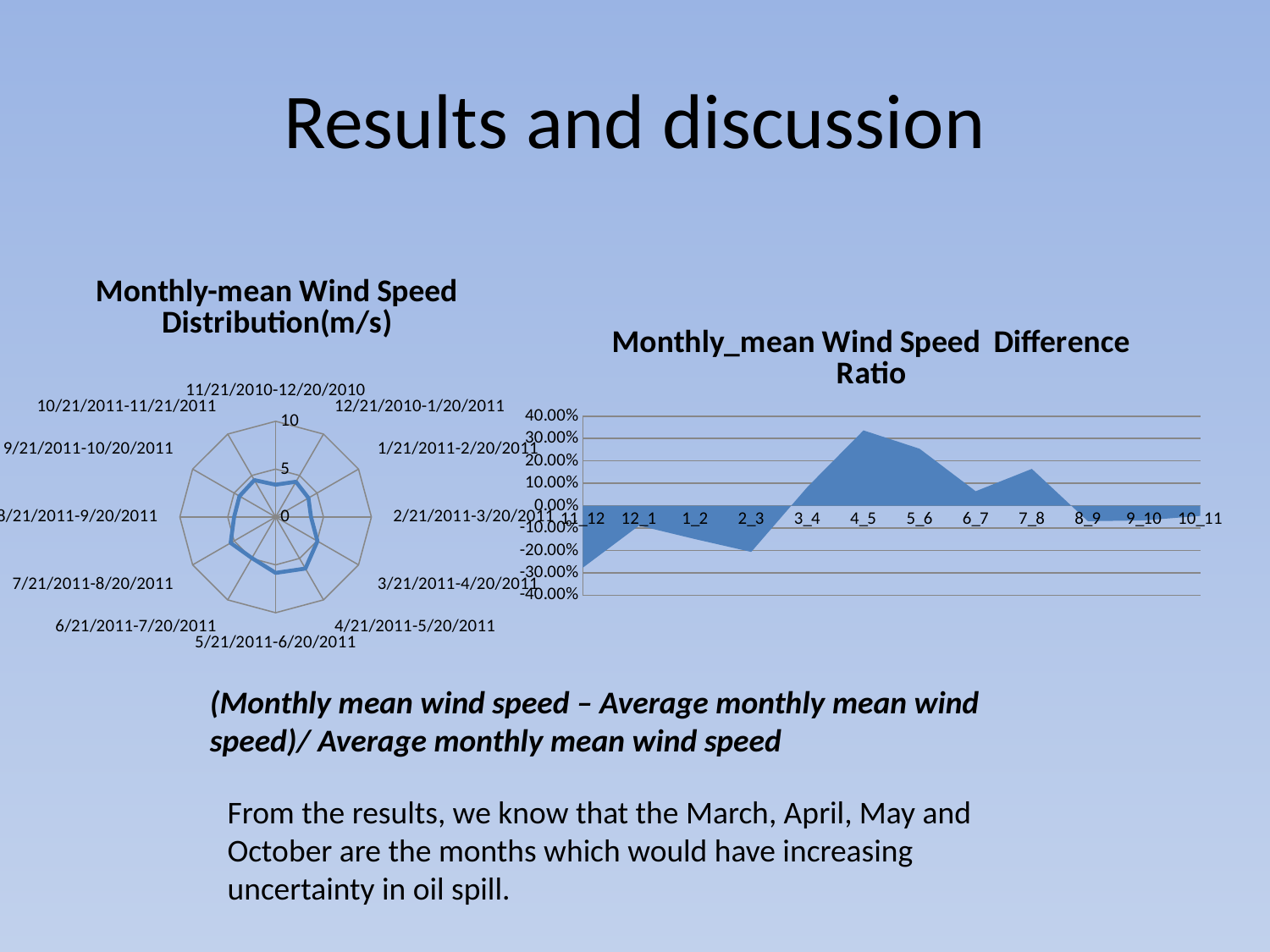
In the 'Monthly_mean Wind Speed Difference Ratio' chart, which category has the highest value? 4_5 In the 'Monthly_mean Wind Speed Difference Ratio' chart, is the value for 4_5 greater or less than 20.00%? greater In the 'Monthly-mean Wind Speed Distribution(m/s)' radar chart, is the value for 4/21/2011-5/20/2011 greater or less than 10? less How many categories are plotted on the 'Monthly_mean Wind Speed Difference Ratio' chart? 12 In the 'Monthly_mean Wind Speed Difference Ratio' chart, do the values rise or fall from 4_5 to 6_7? fall In the 'Monthly_mean Wind Speed Difference Ratio' chart, which category has the lowest value? 11_12 How many date-range categories are shown on the 'Monthly-mean Wind Speed Distribution(m/s)' radar chart? 12 In the 'Monthly_mean Wind Speed Difference Ratio' chart, is the value for 11_12 greater or less than -20.00%? less In the 'Monthly_mean Wind Speed Difference Ratio' chart, which is larger, the value for 4_5 or the value for 2_3? 4_5 What type of chart is the 'Monthly-mean Wind Speed Distribution(m/s)' chart? radar chart What type of chart is the 'Monthly_mean Wind Speed Difference Ratio' chart? area chart